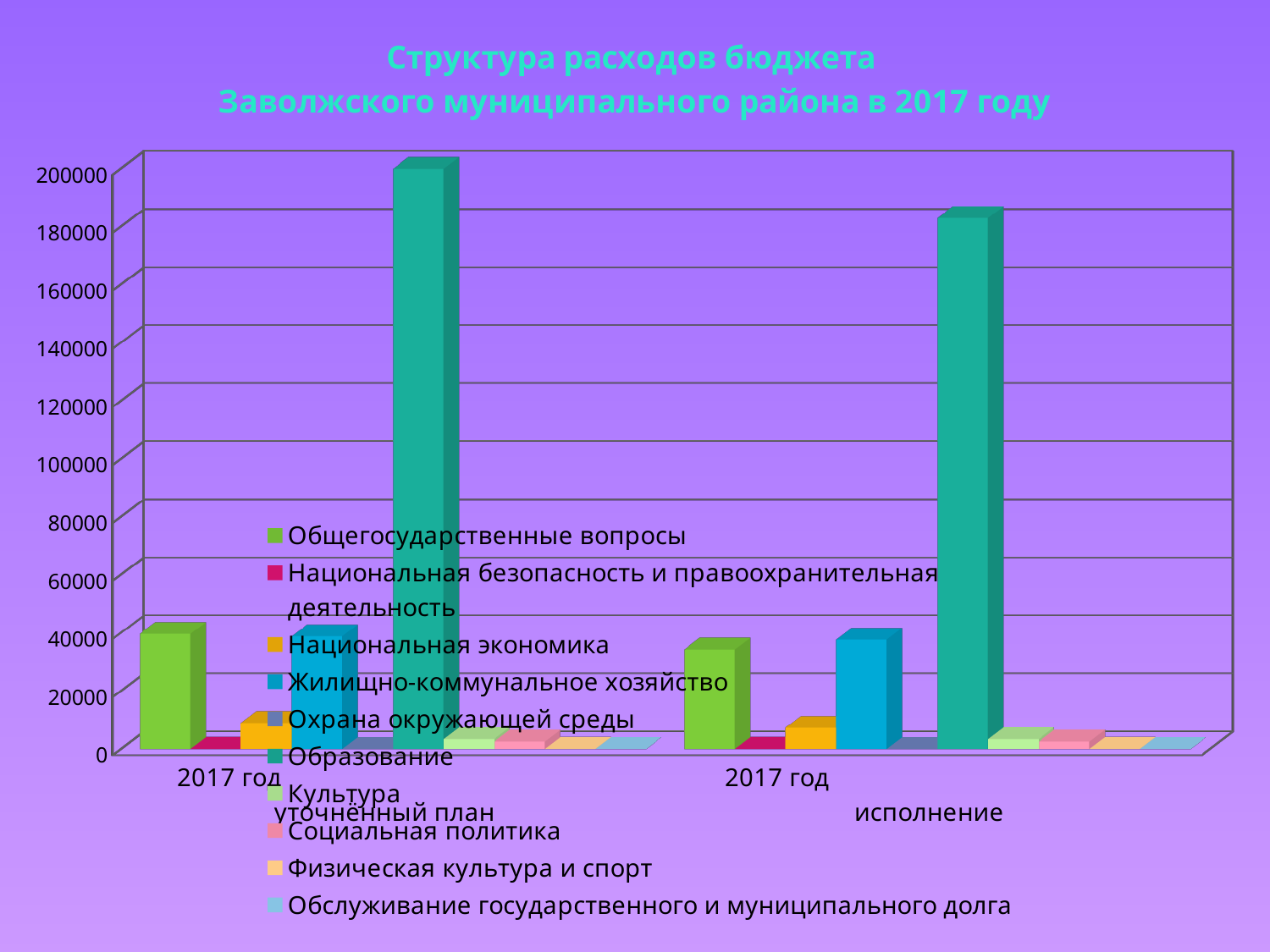
Which is larger for Образование: the "2017 год уточнённый план" value or the "2017 год исполнение" value? 2017 год уточнённый план What is the title of the chart? Структура расходов бюджета Заволжского муниципального района в 2017 году Is the value for Общегосударственные вопросы in the "2017 год уточнённый план" group greater or less than 20000? greater Is the value for Образование in the "2017 год исполнение" group greater or less than 200000? less Is the value for Национальная экономика in the "2017 год исполнение" group greater or less than 20000? less How many series does the legend list? 10 What kind of chart is shown on the slide? bar chart How many category groups are shown on the x axis? 2 Which series has the highest value in the "2017 год исполнение" group? Образование Which series has the highest value in the "2017 год уточнённый план" group? Образование In the "2017 год уточнённый план" group, which is larger: Общегосударственные вопросы or Национальная экономика? Общегосударственные вопросы